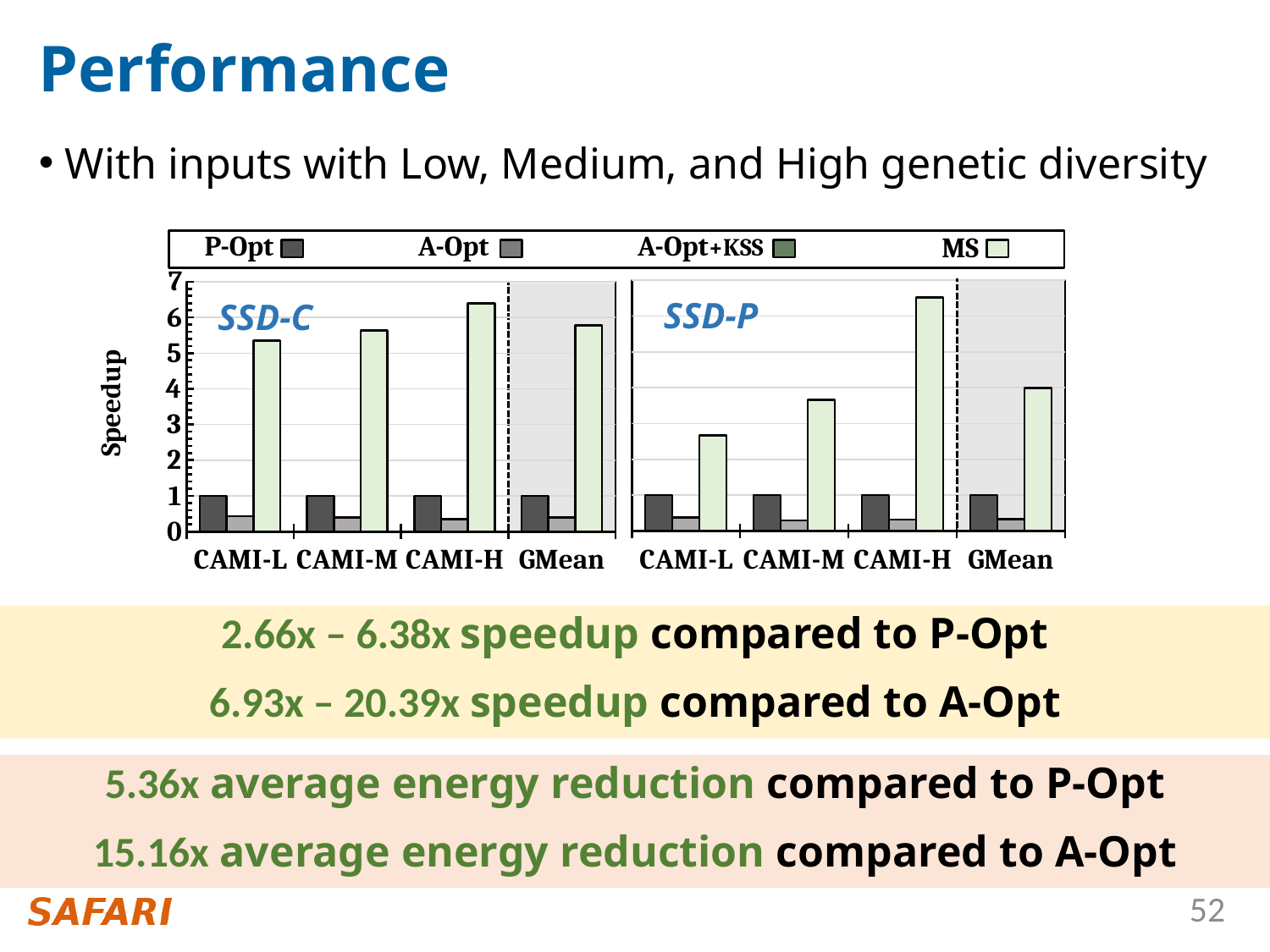
How many categories are shown on the x axis of the SSD-C panel? 4 In the SSD-P panel, which category has the highest MS bar? CAMI-H In the SSD-C panel, is the MS value for CAMI-L greater or less than 5? greater In the SSD-P panel, is the MS value for CAMI-L greater or less than 3? less How many series does the legend list? 4 In the SSD-P panel, which category has the lowest MS bar? CAMI-L In the SSD-P panel, is the MS value for GMean greater or less than 5? less In the SSD-P panel, which is larger, the MS bar for CAMI-M or the MS bar for CAMI-L? CAMI-M In the SSD-P panel, do the MS bars rise or fall from CAMI-L to CAMI-H? rise What kind of chart is shown on the slide? bar chart In the SSD-C panel, which category has the highest MS bar? CAMI-H What is the label of the y axis? Speedup